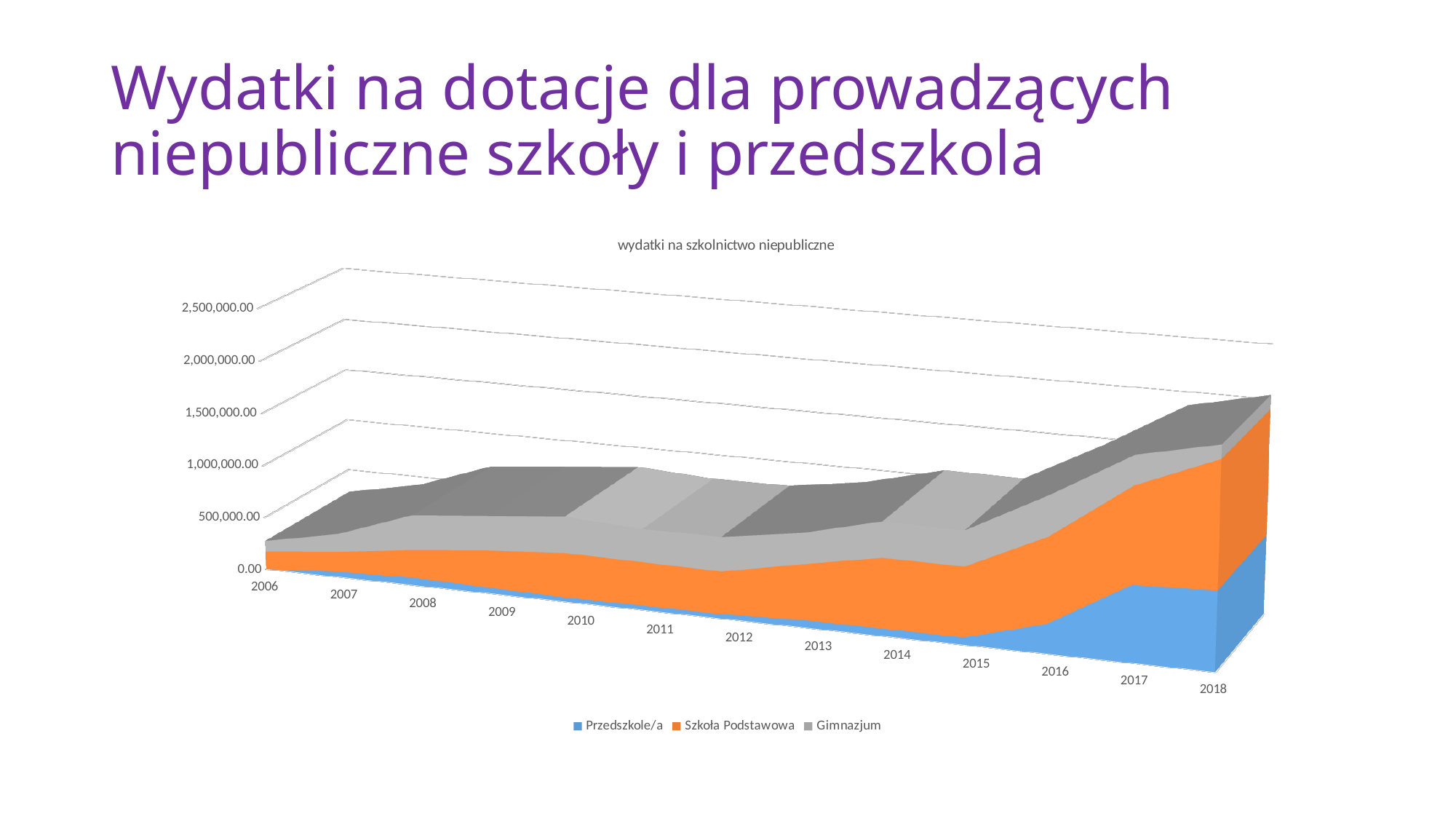
How many series does the legend list? 3 Overall, do total expenditures rise or fall from 2006 to 2018? rise What is the title of the chart? wydatki na szkolnictwo niepubliczne How many years are shown on the x axis? 13 What is the last year shown on the x axis? 2018 What type of chart is shown on the slide? area chart Which year has the lowest total expenditure? 2006 Which series are listed in the legend? Przedszkole/a, Szkoła Podstawowa, Gimnazjum Is the total expenditure larger in 2018 or in 2006? 2018 Which year has the highest total expenditure? 2018 What is the first year shown on the x axis? 2006 Is the total expenditure for 2006 greater or less than 500,000.00? less